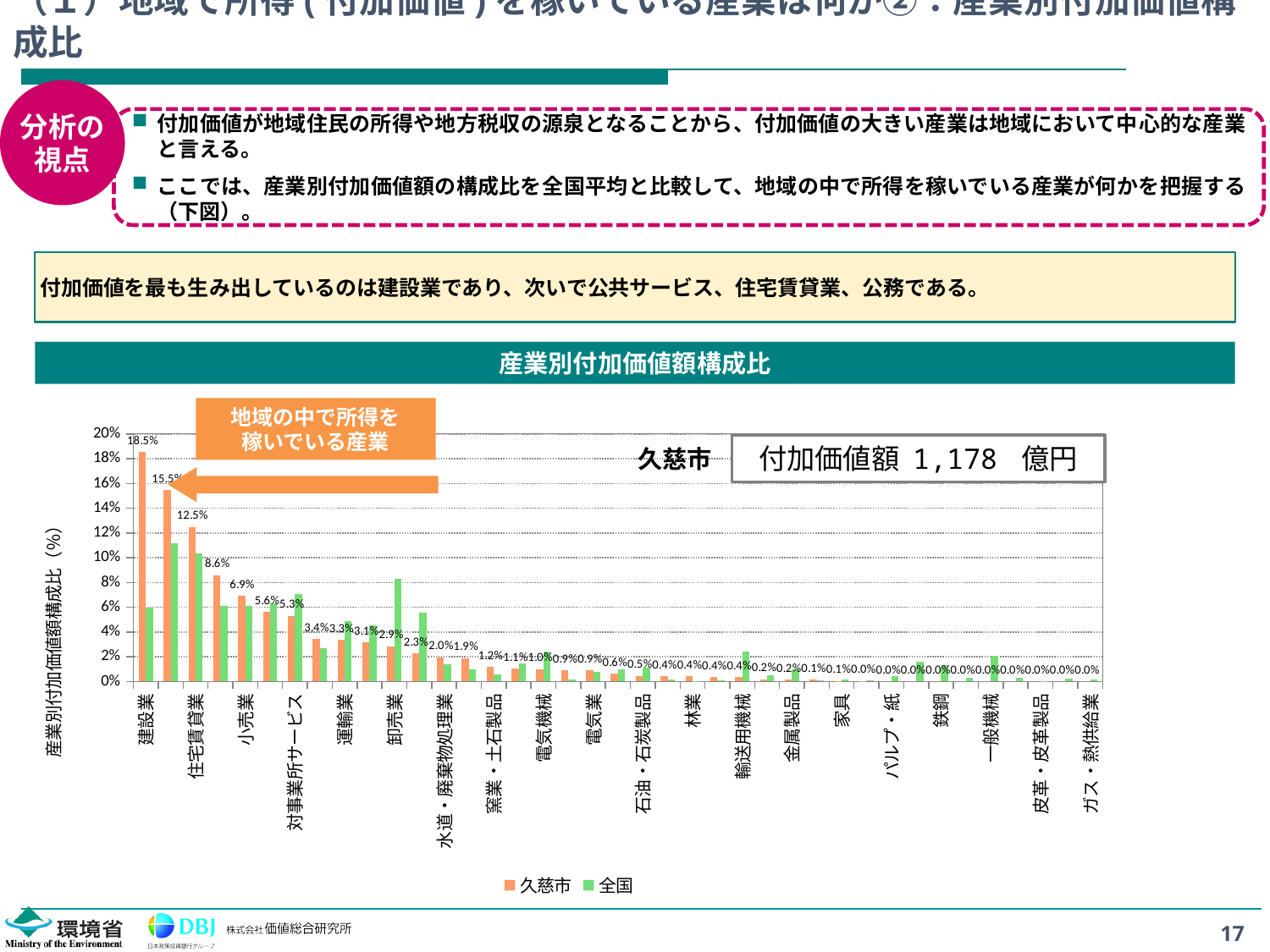
What is the 久慈市 value for 卸売業? 2.9% What is the 久慈市 value for 住宅賃貸業? 12.5% What are the two series named in the chart legend? 久慈市 and 全国 What kind of chart is shown on the slide? Bar chart What is the 久慈市 value for 建設業? 18.5% What is the 久慈市 value for 小売業? 6.9% What is the difference between the 久慈市 values for 建設業 and 住宅賃貸業? 6.0% For 卸売業, which series has the larger value, 久慈市 or 全国? 全国 Is the 全国 value for 建設業 greater or less than 10%? less Which industry has the highest 久慈市 share in the chart? 建設業 How many series does the chart legend list? 2 Do the 久慈市 values rise or fall moving from left to right along the x axis? fall